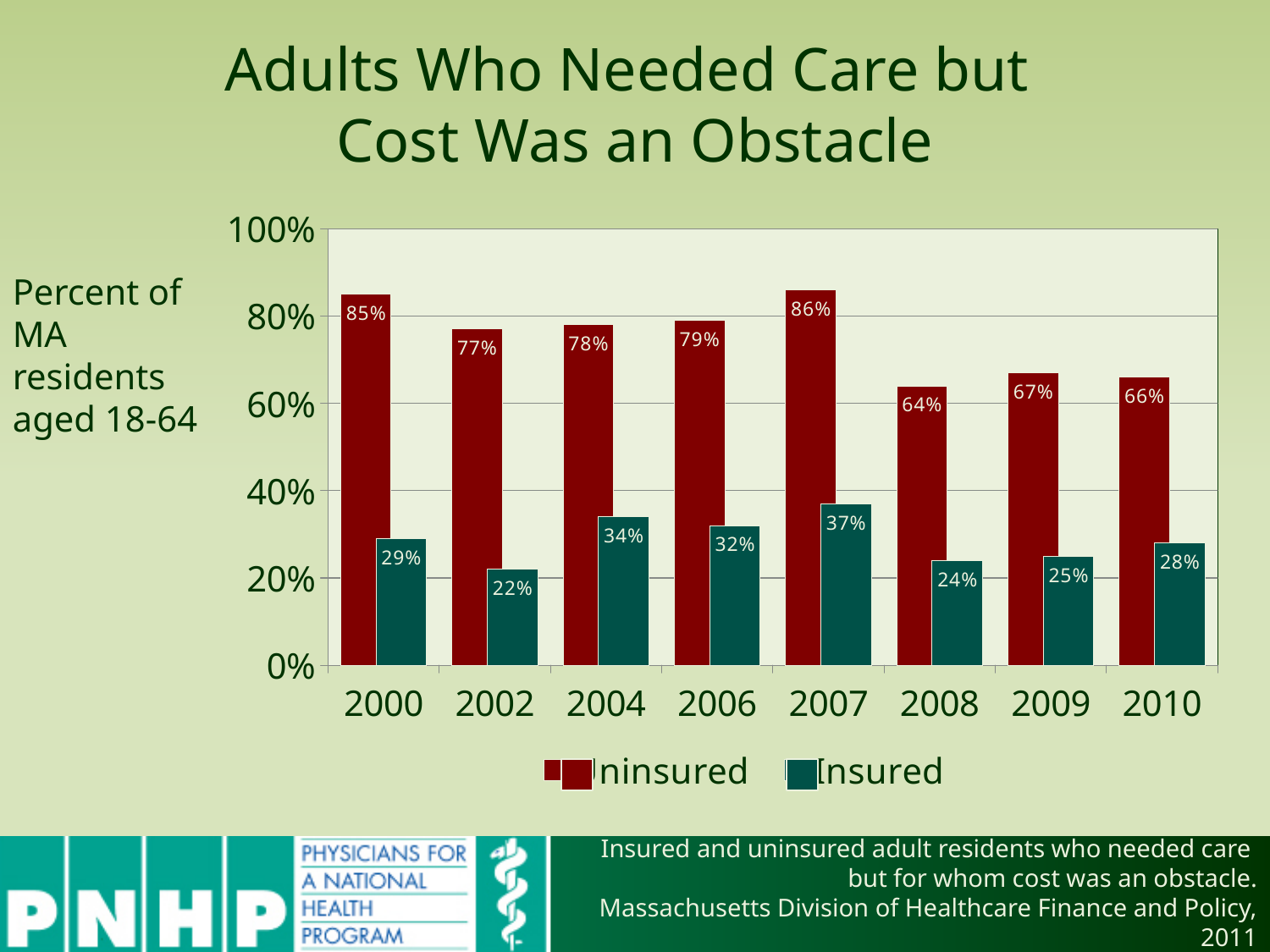
What colour are the Insured bars? Teal What is the value for Insured in 2010? 28% What is the value for Uninsured in 2007? 86% What kind of chart is shown on the slide? Bar chart What is the value for Insured in 2002? 22% How many series does the legend list? 2 In which year is the Insured value lowest? 2002 In which year is the Uninsured value lowest? 2008 How many years are shown on the x axis? 8 In which year is the Uninsured value highest? 2007 Which is larger, the Insured value in 2007 or the Insured value in 2004? 2007 What is the difference between the Uninsured and Insured values in 2000? 56%